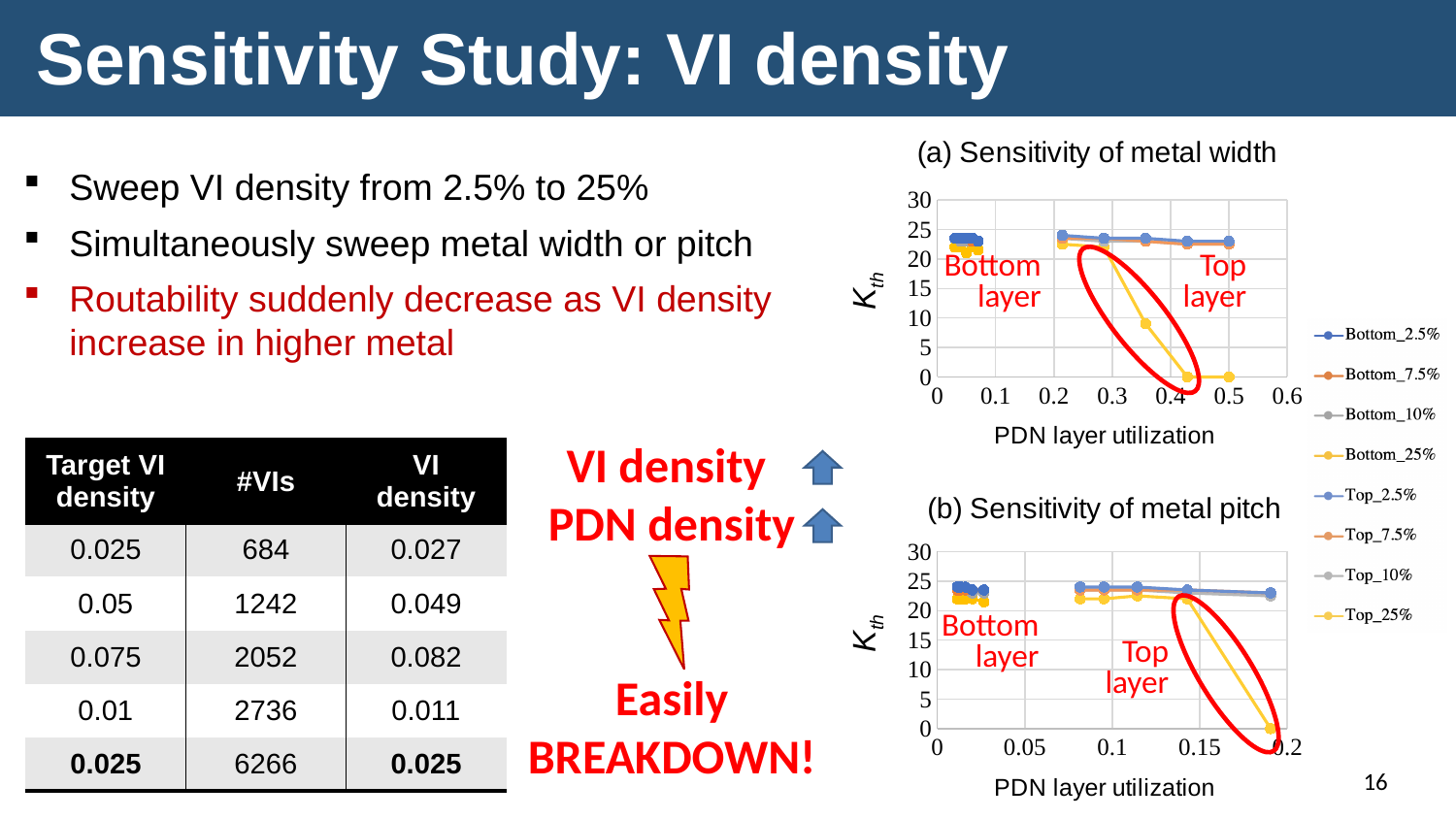
In chart (b) Sensitivity of metal pitch, is the rightmost value of the Top_25% series greater or less than 5? less How many series does the legend next to the charts list? 8 What is the title of the upper chart on the slide? (a) Sensitivity of metal width In chart (b) Sensitivity of metal pitch, at the rightmost point, which is larger: Top_2.5% or Top_25%? Top_2.5% In chart (a) Sensitivity of metal width, are the Bottom layer values near PDN layer utilization 0.05 greater or less than 20? greater What is the x-axis label of the chart '(b) Sensitivity of metal pitch'? PDN layer utilization In chart (a) Sensitivity of metal width, at PDN layer utilization 0.5, which is larger: Top_2.5% or Top_25%? Top_2.5% What kind of chart is '(a) Sensitivity of metal width'? line chart In chart (b) Sensitivity of metal pitch, does the Top_25% series rise or fall as PDN layer utilization increases? fall In chart (a) Sensitivity of metal width, is the value of the Top_25% series at PDN layer utilization 0.35 greater or less than 15? less In chart (a) Sensitivity of metal width, does the Top_25% series rise or fall as PDN layer utilization increases? fall